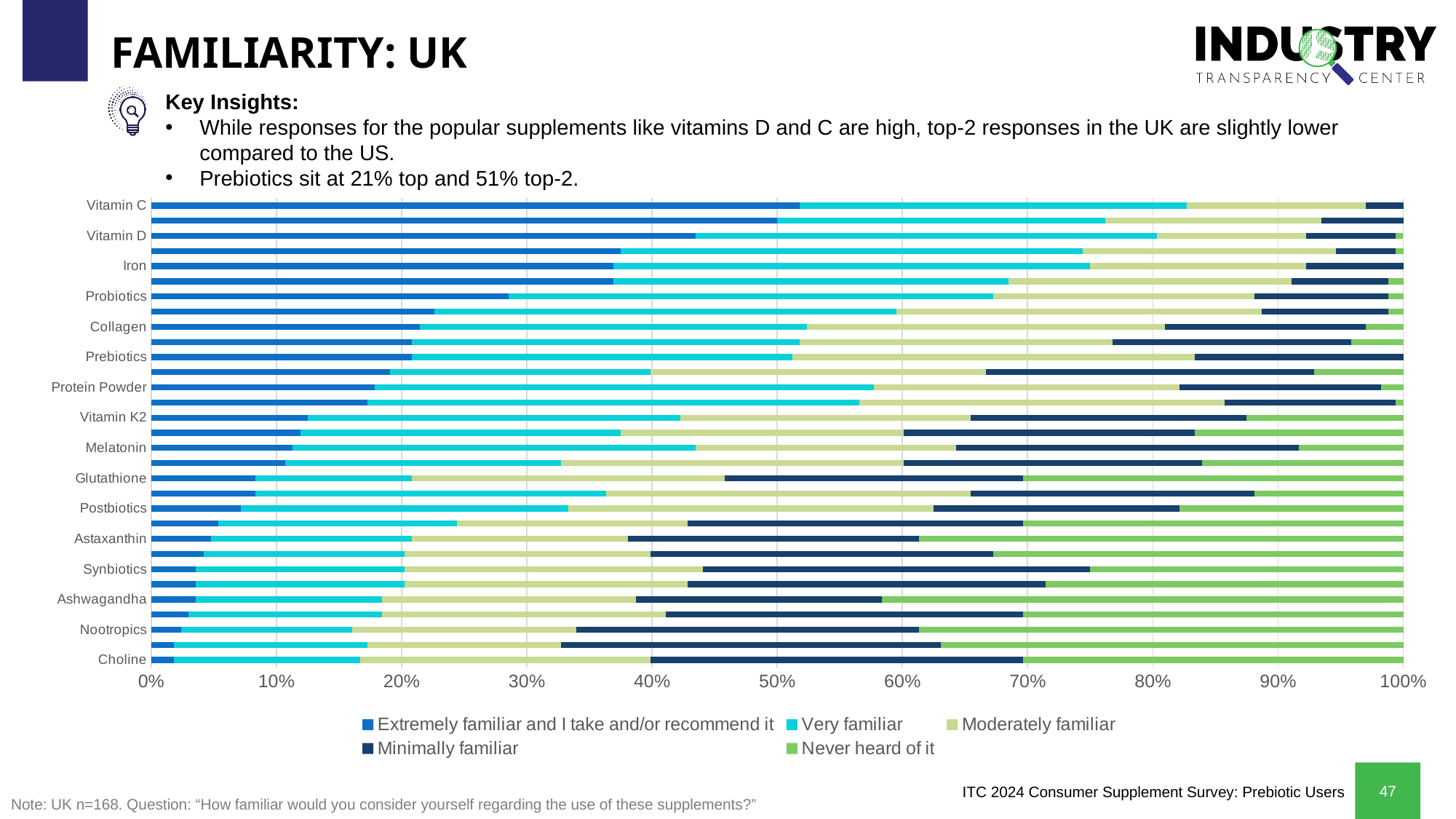
Is the 'Extremely familiar and I take and/or recommend it' value for Glutathione greater or less than 10%? less Which legend entry is shown in green? Never heard of it What is the title of the slide containing the chart? FAMILIARITY: UK Moving down the chart from Vitamin C to Choline, do the 'Extremely familiar and I take and/or recommend it' segments generally get larger or smaller? smaller Is the 'Never heard of it' value for Choline greater or less than 20%? greater According to the key insights on the slide, what is the top-2 familiarity percentage for Prebiotics? 51% How many series does the chart legend list? 5 What kind of chart is shown on the slide? Stacked bar chart Which has the larger 'Extremely familiar and I take and/or recommend it' segment, Vitamin D or Iron? Vitamin D Is the 'Extremely familiar and I take and/or recommend it' value for Choline greater or less than 10%? less Among the labeled supplements, which has the largest 'Extremely familiar and I take and/or recommend it' segment? Vitamin C